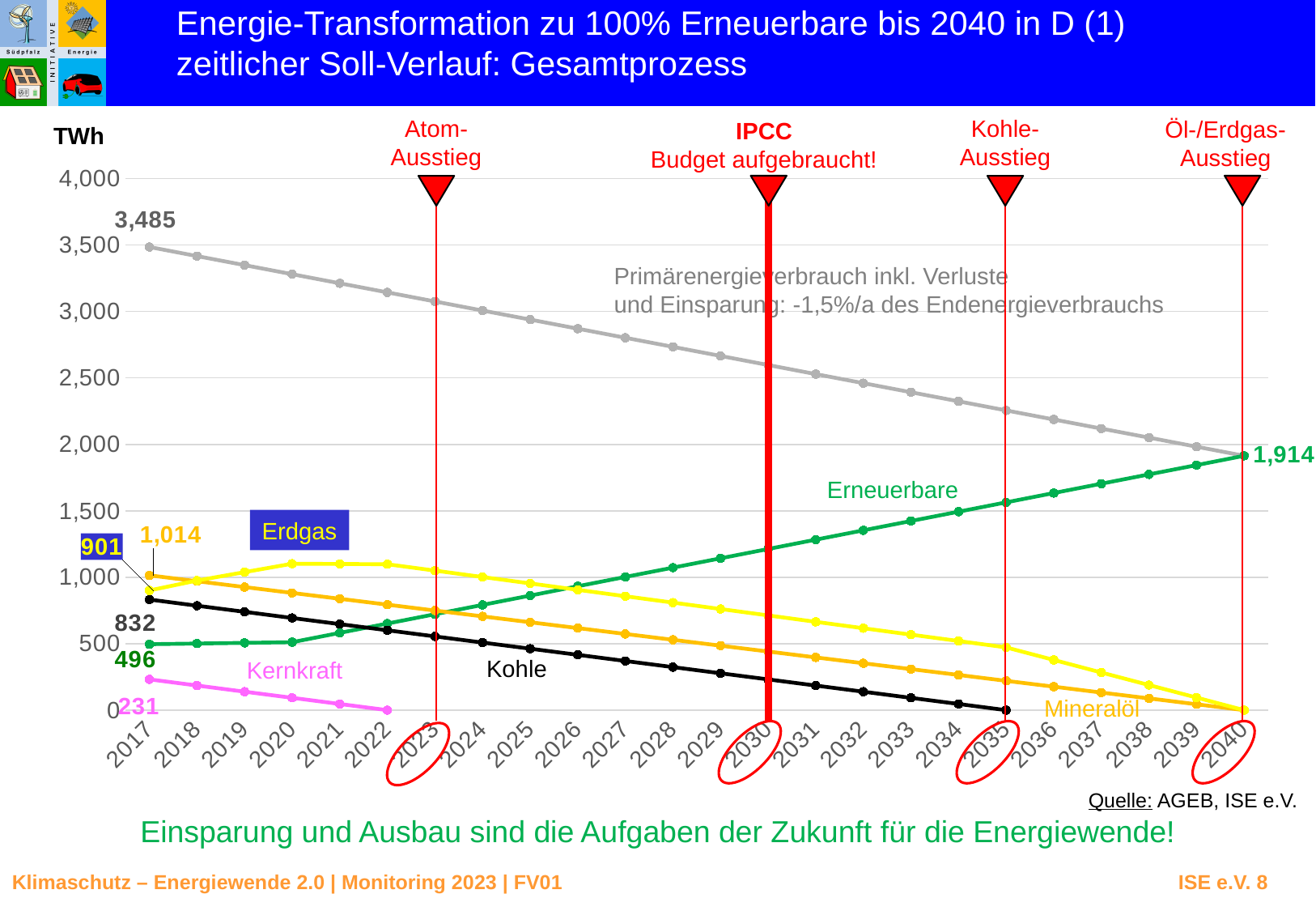
What kind of chart is shown on the slide? line chart What is the value of Mineralöl in 2017? 1,014 Is the value for Kohle in 2030 greater or less than 500? less Does the Primärenergieverbrauch line rise or fall from 2017 to 2040? fall What is the value of Kohle in 2017? 832 What value does the Erneuerbare line reach in 2040? 1,914 Which is larger in 2017, Mineralöl or Erdgas? Mineralöl By how much does the Erneuerbare value increase from 2017 to 2040? 1,418 What is the value of Erneuerbare in 2017? 496 What is the value of Kernkraft in 2017? 231 What unit is shown on the y axis? TWh What is the value of Primärenergieverbrauch in 2017? 3,485